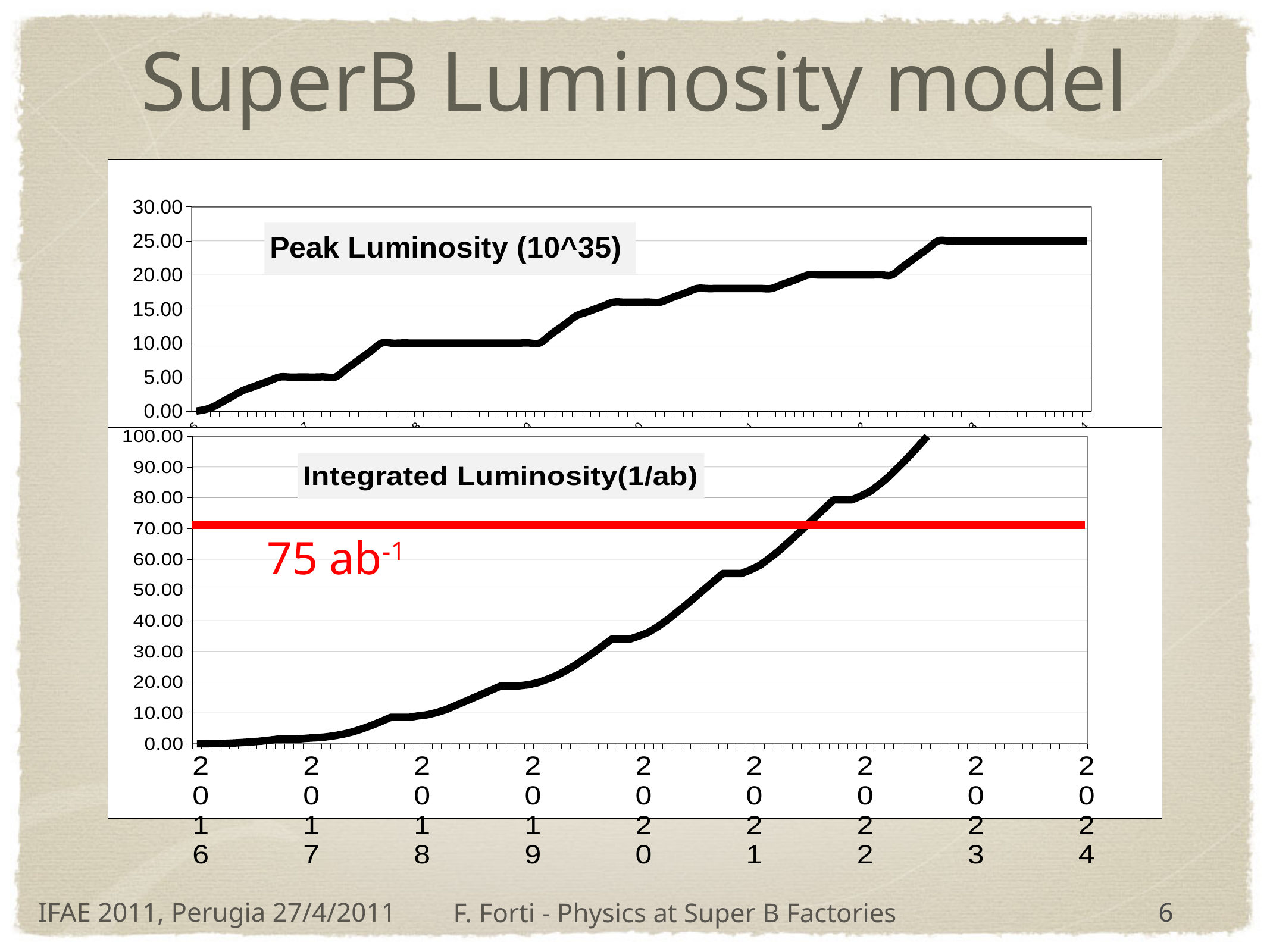
In the bottom chart, Integrated Luminosity(1/ab), do the values rise or fall from 2016 to 2024? rise What is the title of the top chart? Peak Luminosity (10^35) In the top chart, Peak Luminosity (10^35), what value does the line plateau at on the far right of the chart? 25.00 In the top chart, Peak Luminosity (10^35), is the value at the start of 2020 greater or less than 15.00? greater In the top chart, Peak Luminosity (10^35), do the values generally rise or fall along the x axis? rise In the bottom chart, Integrated Luminosity(1/ab), is the value at the start of 2022 greater or less than 50.00? greater What kind of chart is the top chart, Peak Luminosity (10^35)? line chart In the bottom chart, Integrated Luminosity(1/ab), is the value at the start of 2020 greater or less than 30.00? greater What label is written next to the red horizontal line in the bottom chart? 75 ab-1 What kind of chart is the bottom chart, Integrated Luminosity(1/ab)? line chart